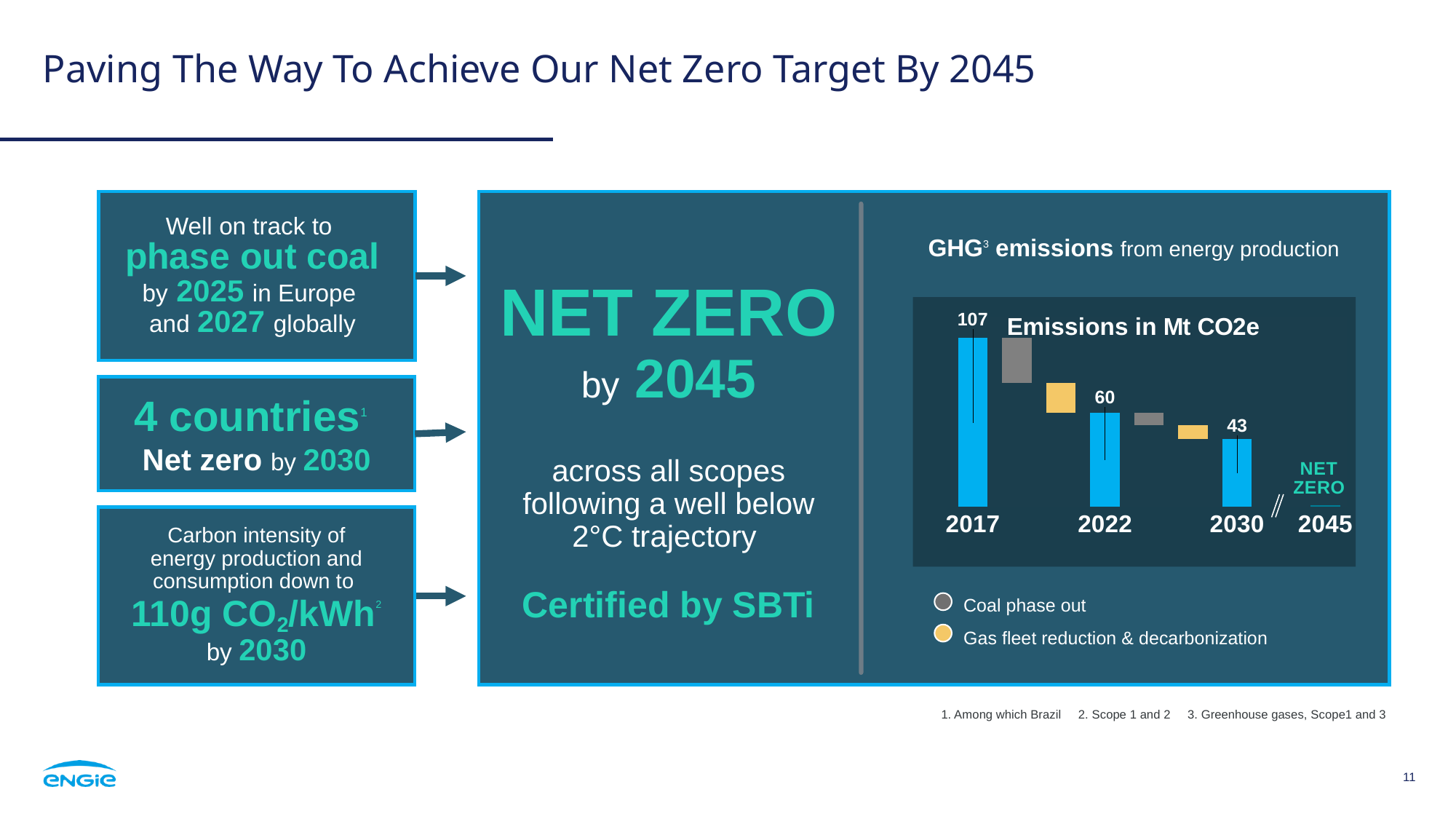
Which is larger, the emissions value for 2022 or for 2030? 2022 What kind of chart is used to show GHG emissions from energy production? bar chart What is the difference between the emissions values for 2017 and 2022? 47 What is the emissions value shown for 2022? 60 What is the emissions value shown for 2030? 43 What does the yellow colour in the chart legend represent? Gas fleet reduction & decarbonization Which year has the highest emissions value in the chart? 2017 Which labelled year has the lowest emissions value in the chart? 2030 What is the difference between the emissions values for 2022 and 2030? 17 What is the emissions value shown for 2017? 107 What unit are the emissions in the chart expressed in? Mt CO2e Do the emissions values rise or fall from 2017 to 2030? fall